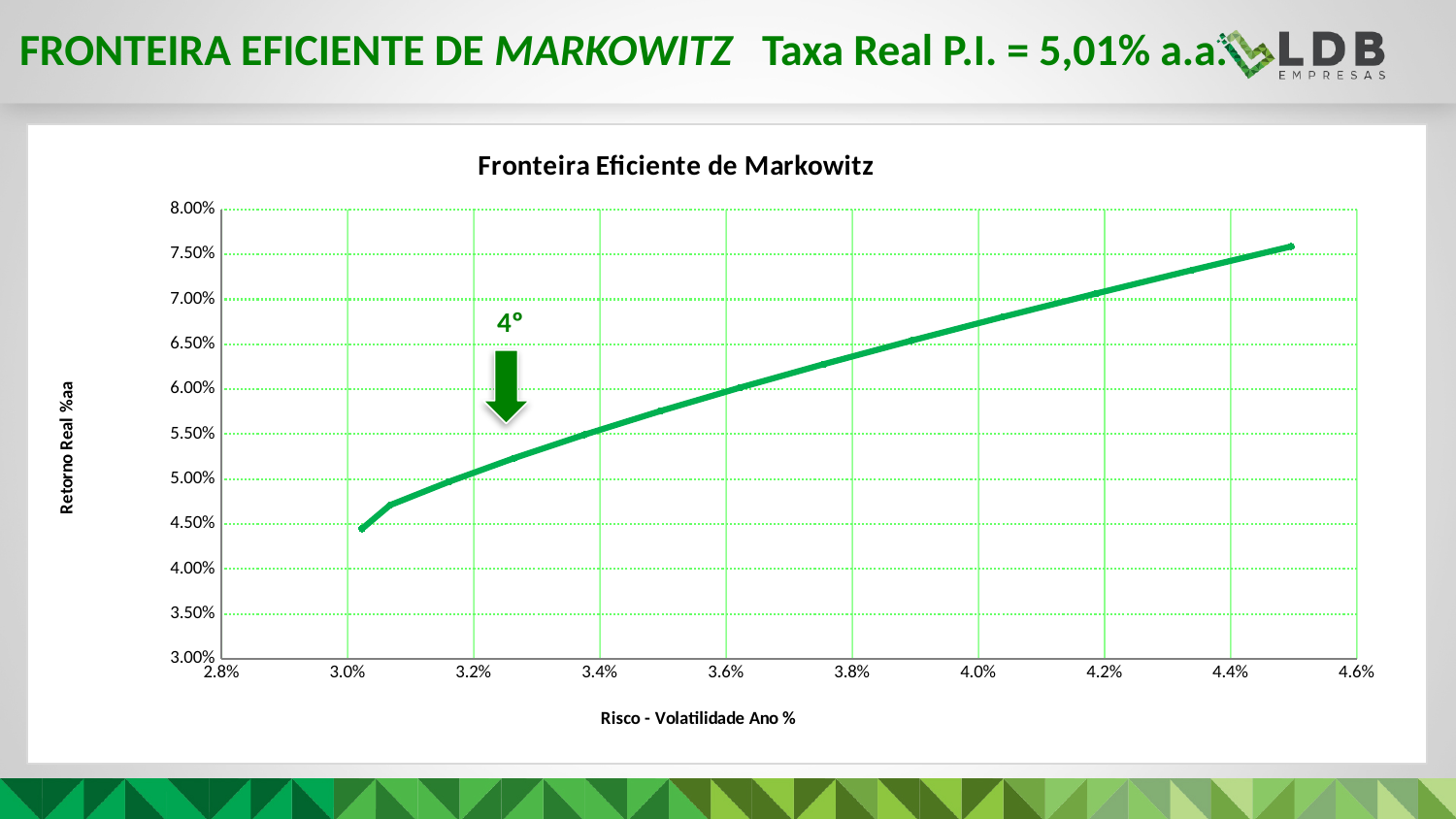
Is the return value of the line at a volatility of 4.4% greater or less than 7.00%? greater Is the return value of the line at a volatility of 3.6% greater or less than 6.50%? less Is the return value at the right end of the line (near 4.5% volatility) greater or less than 8.00%? less What is the title of the chart? Fronteira Eficiente de Markowitz What is the label of the x axis of the chart? Risco - Volatilidade Ano % Does the line in the chart rise or fall as risk (volatility) increases along the x axis? rise What kind of chart is shown on the slide? line chart